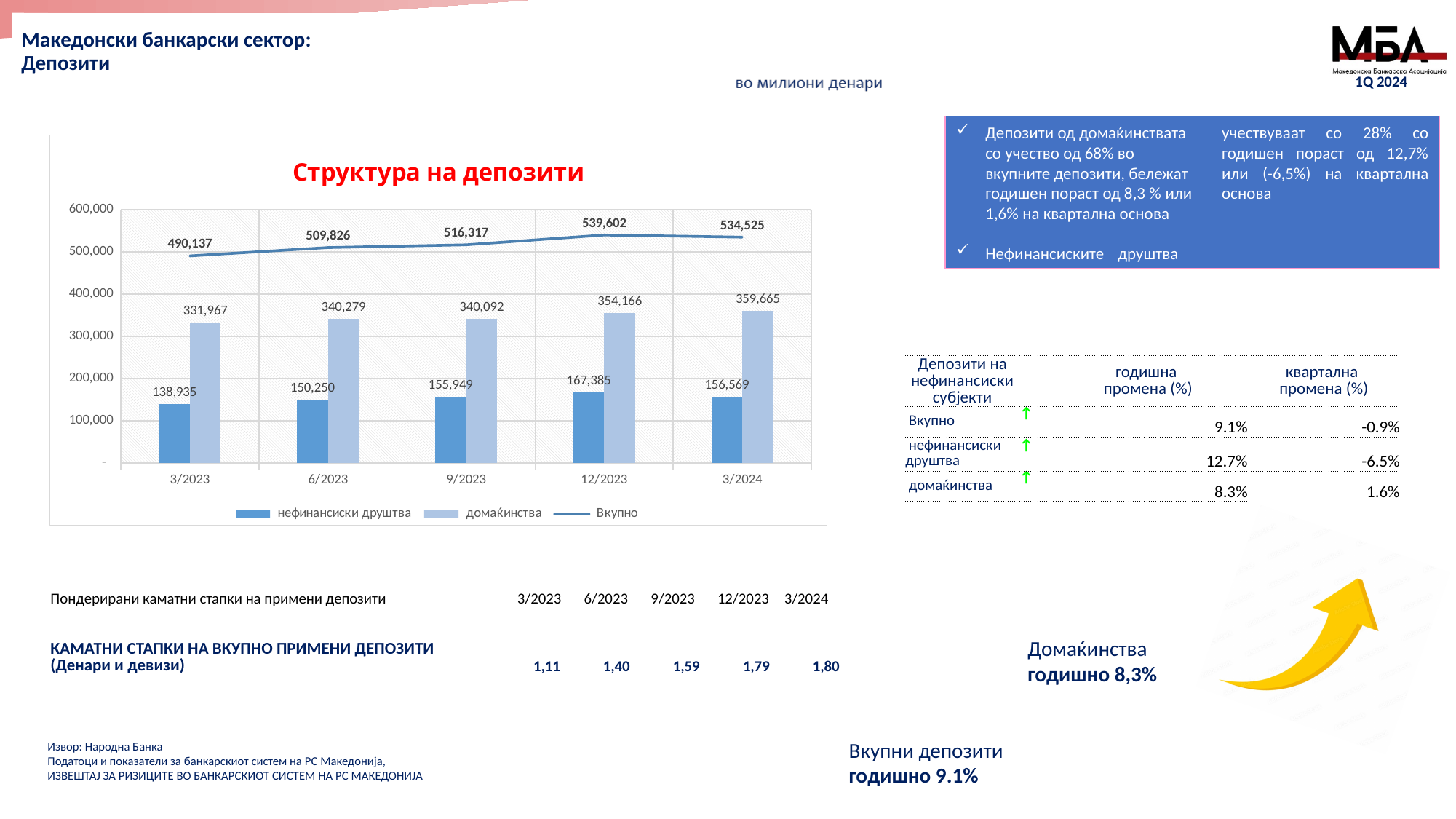
Does the value for домаќинства rise or fall from 3/2023 to 3/2024? rise How many periods are shown on the x axis? 5 What is the title of the chart? Структура на депозити Which is larger in 9/2023: нефинансиски друштва or домаќинства? домаќинства In which period is the value for нефинансиски друштва lowest? 3/2023 How many series does the legend list? 3 What is the value for домаќинства in 3/2024? 359,665 What is the value for нефинансиски друштва in 12/2023? 167,385 What is the difference between the Вкупно values in 12/2023 and 3/2024? 5,077 In which period is the Вкупно line at its highest? 12/2023 Is the value for домаќинства in 6/2023 greater or less than 300,000? greater What is the Вкупно value in 3/2023? 490,137